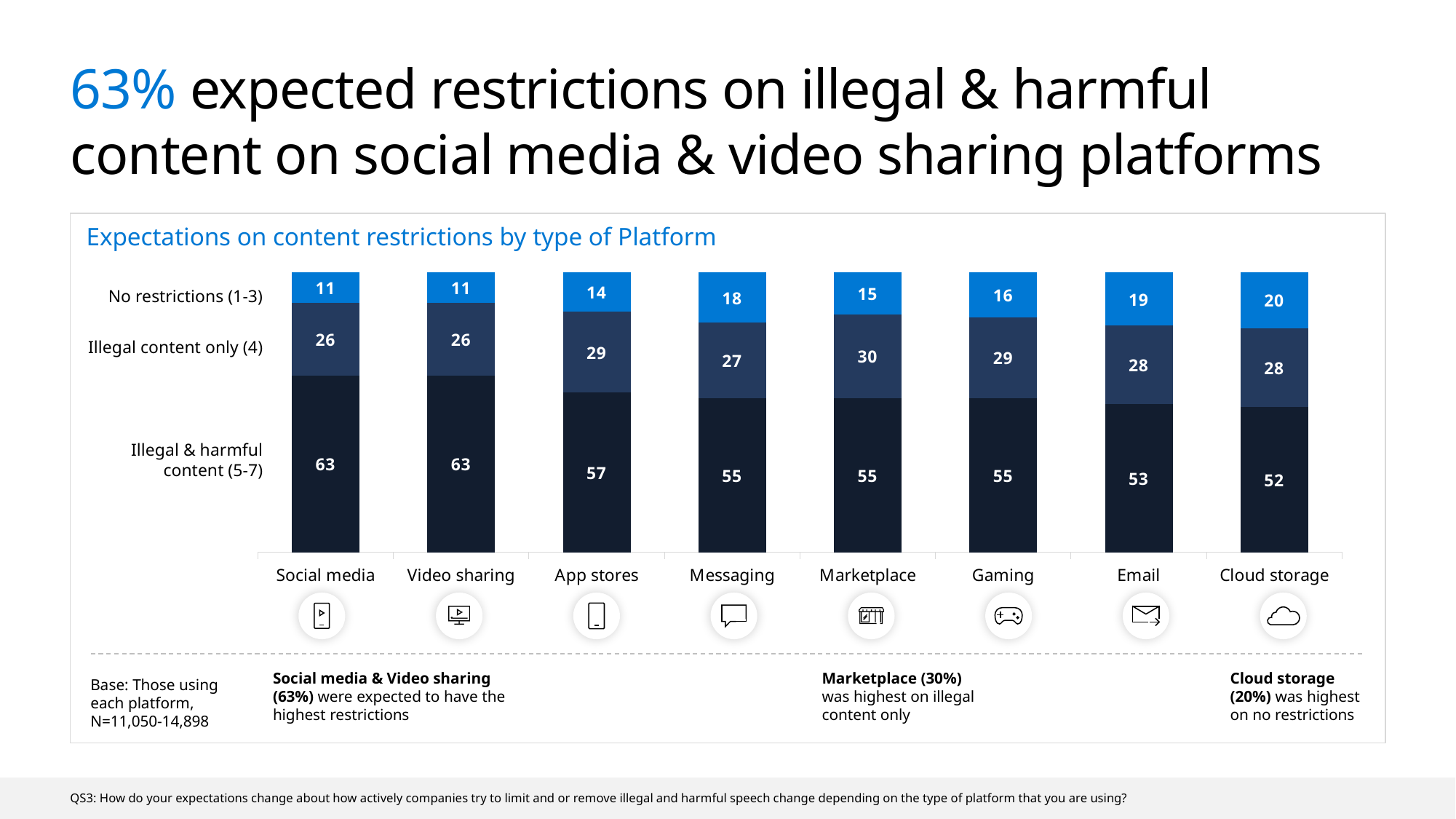
What is the difference between the Illegal & harmful content (5-7) values for Social media and Cloud storage? 11 What is the value for Illegal content only (4) for Marketplace? 30 What is the value for Illegal & harmful content (5-7) for App stores? 57 What is the value for No restrictions (1-3) for Email? 19 Which platform has the lowest value for Illegal & harmful content (5-7)? Cloud storage What is the total of the stacked bar for Gaming? 100 What kind of chart is this? Stacked bar chart Which platform has the highest value for No restrictions (1-3)? Cloud storage Which is larger: the No restrictions (1-3) value for Messaging or for Marketplace? Messaging How many platforms are shown on the x axis? 8 How many series does the chart show? 3 What is the title of the chart? Expectations on content restrictions by type of Platform